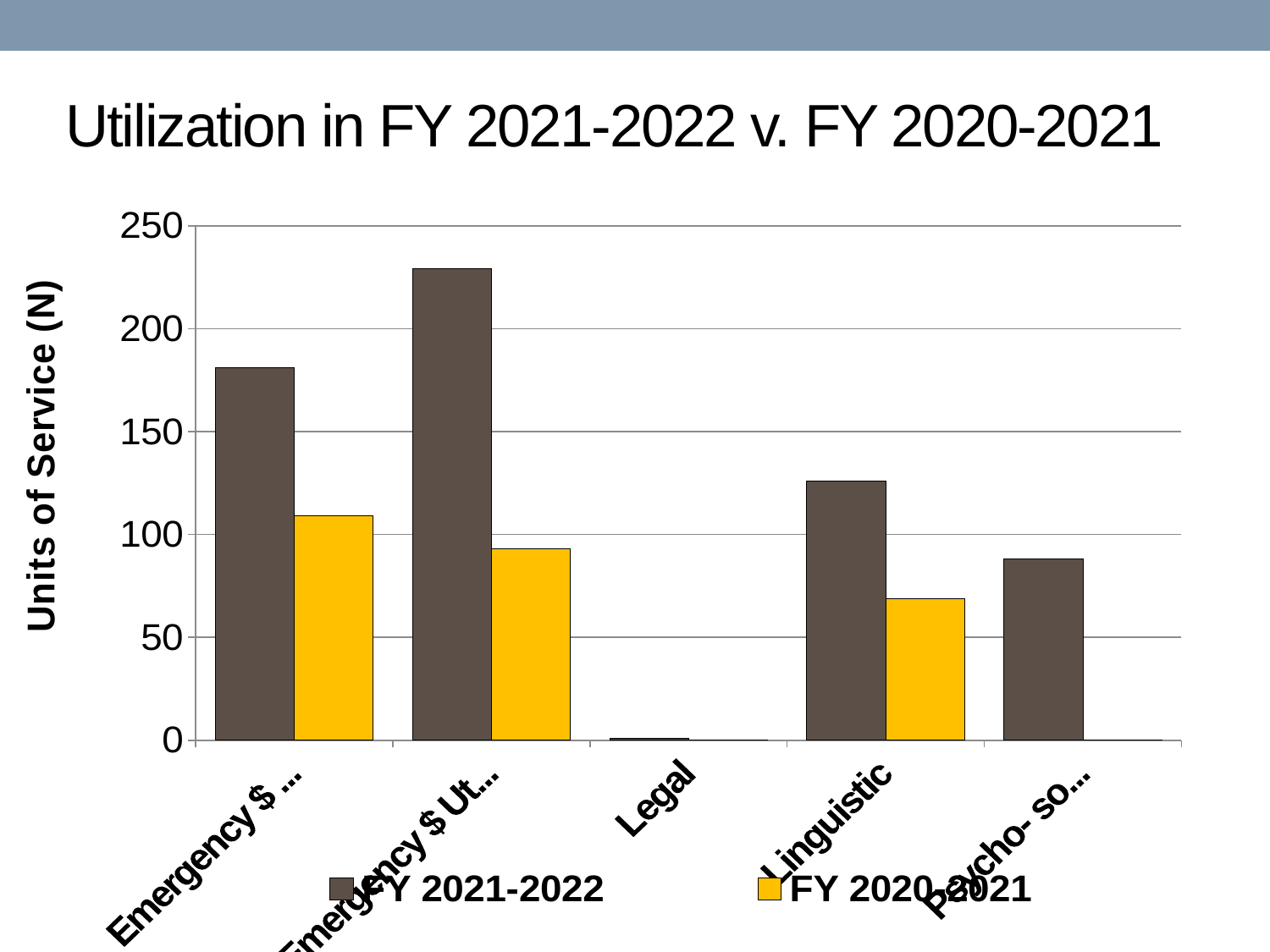
Is the FY 2020-2021 value for Linguistic greater or less than 50? greater Which is larger, the FY 2021-2022 value for Linguistic or the FY 2021-2022 value for Legal? Linguistic Is the FY 2020-2021 value for Linguistic greater or less than 100? less Which category has the lowest FY 2021-2022 value? Legal How many categories are plotted along the x axis? 5 What kind of chart is shown on the slide? bar chart For Linguistic, which series has the larger value, FY 2021-2022 or FY 2020-2021? FY 2021-2022 What is the title of the y axis? Units of Service (N) How many series does the legend list? 2 Which two series are listed in the legend? FY 2021-2022 and FY 2020-2021 Is the FY 2021-2022 value for Linguistic greater or less than 100? greater